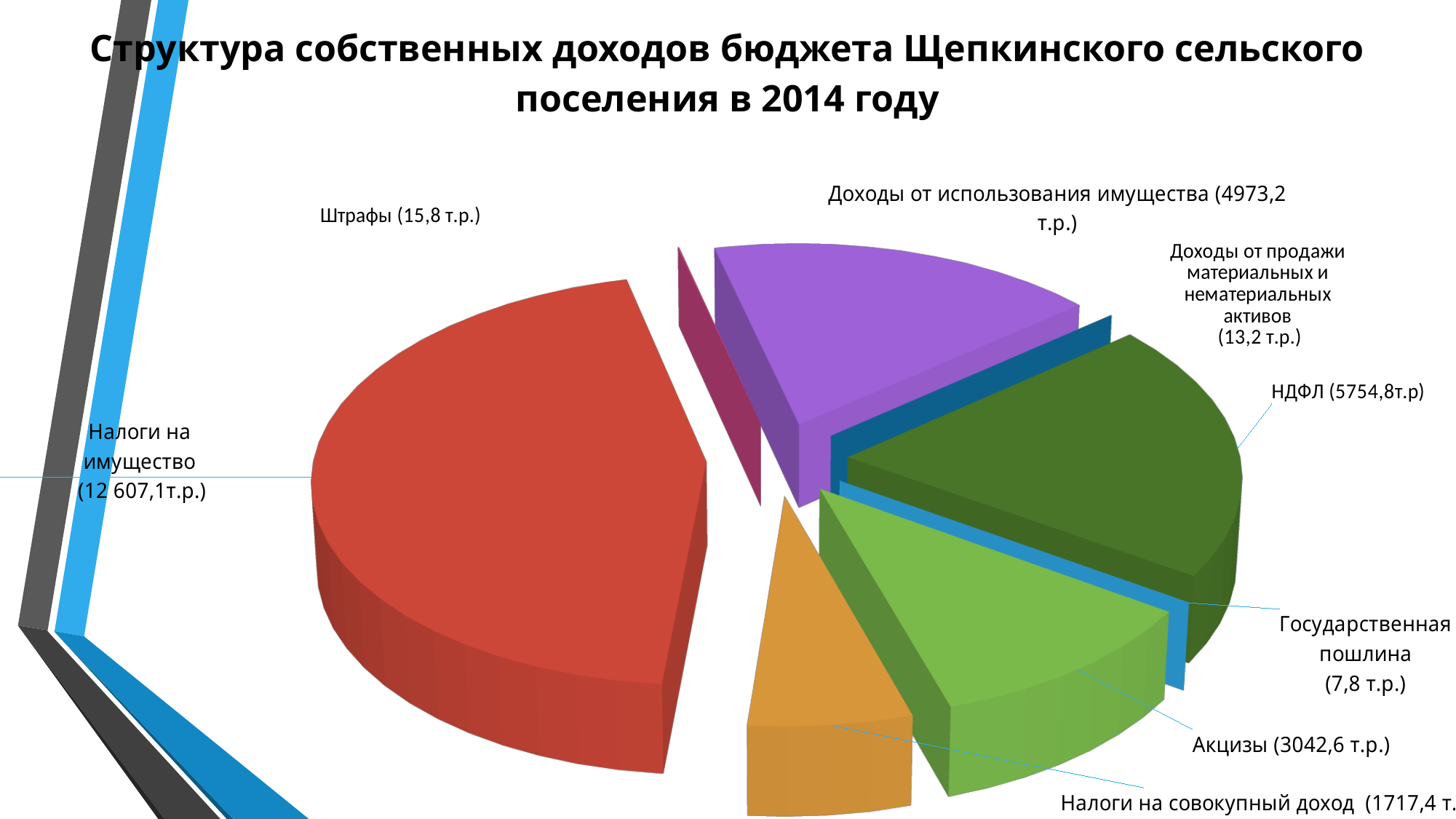
What is the value shown for Налоги на имущество? 12 607,1 т.р. Which category has the largest value in the pie chart? Налоги на имущество Which category has the smallest value in the pie chart? Государственная пошлина How many categories (slices) does the pie chart show? 8 What is the value shown for Доходы от использования имущества? 4973,2 т.р. What type of chart is shown on the slide? Pie chart What is the value shown for НДФЛ? 5754,8 т.р. What is the title of the chart? Структура собственных доходов бюджета Щепкинского сельского поселения в 2014 году What is the difference between the values for Акцизы and Налоги на совокупный доход? 1325,2 т.р. What is the difference between the values for НДФЛ and Доходы от использования имущества? 781,6 т.р. Which is larger: Штрафы or Доходы от продажи материальных и нематериальных активов? Штрафы What is the value shown for Акцизы? 3042,6 т.р.